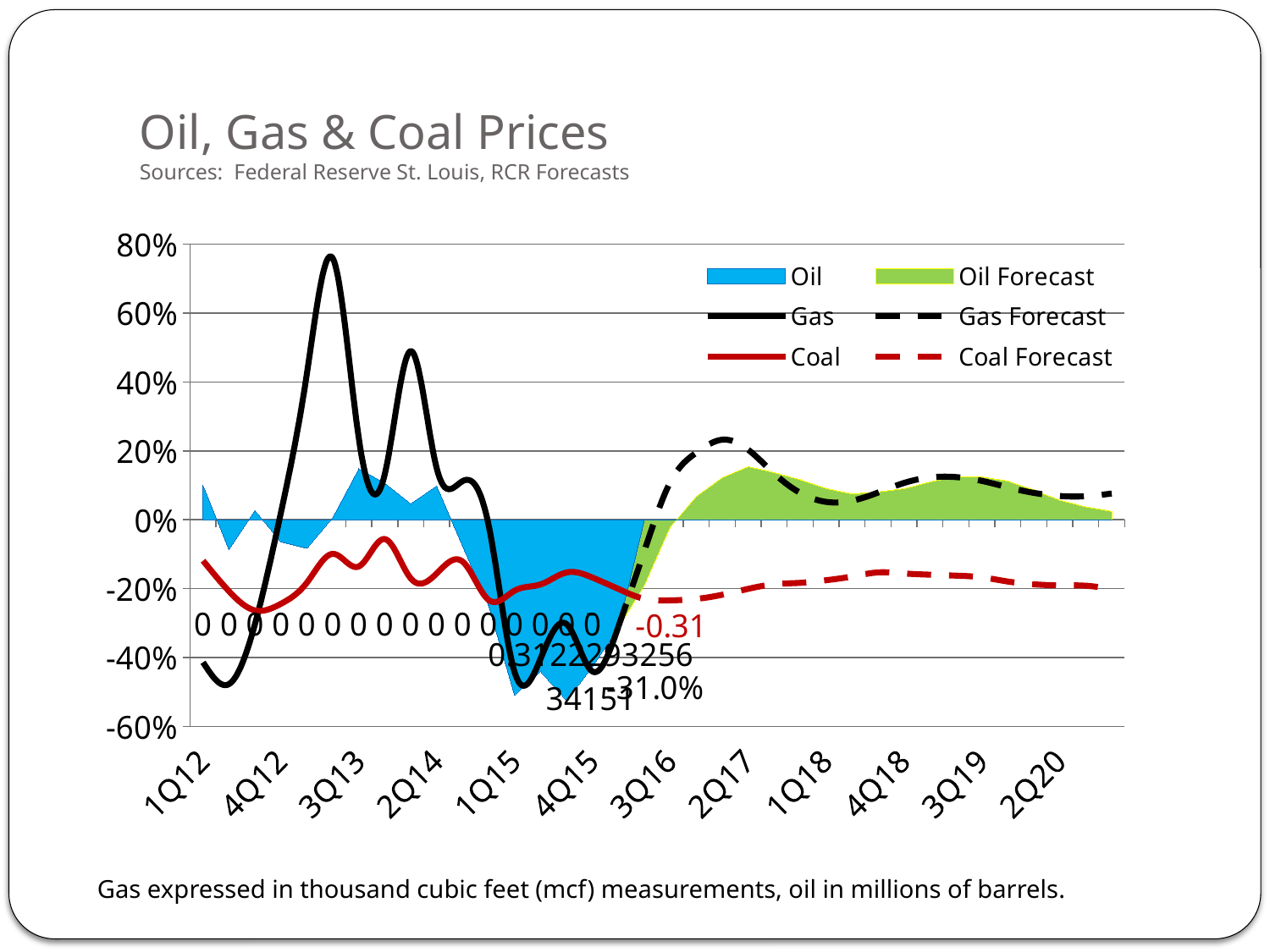
Does the Gas series rise or fall between 4Q12 and 3Q13? rise What is the title of the chart? Oil, Gas & Coal Prices Which series reaches the highest value on the chart? Gas How many quarter labels are shown along the x axis? 12 Is the lowest value of the Gas series around 1Q15 greater or less than -40%? less How many series does the chart legend list? 6 Is the Coal Forecast value at 2Q20 greater or less than 0%? less Is the peak value of the Gas series around 3Q13 greater or less than 60%? greater At 3Q13, which is higher, Gas or Coal? Gas What colour is used for the Oil series in the legend? Blue